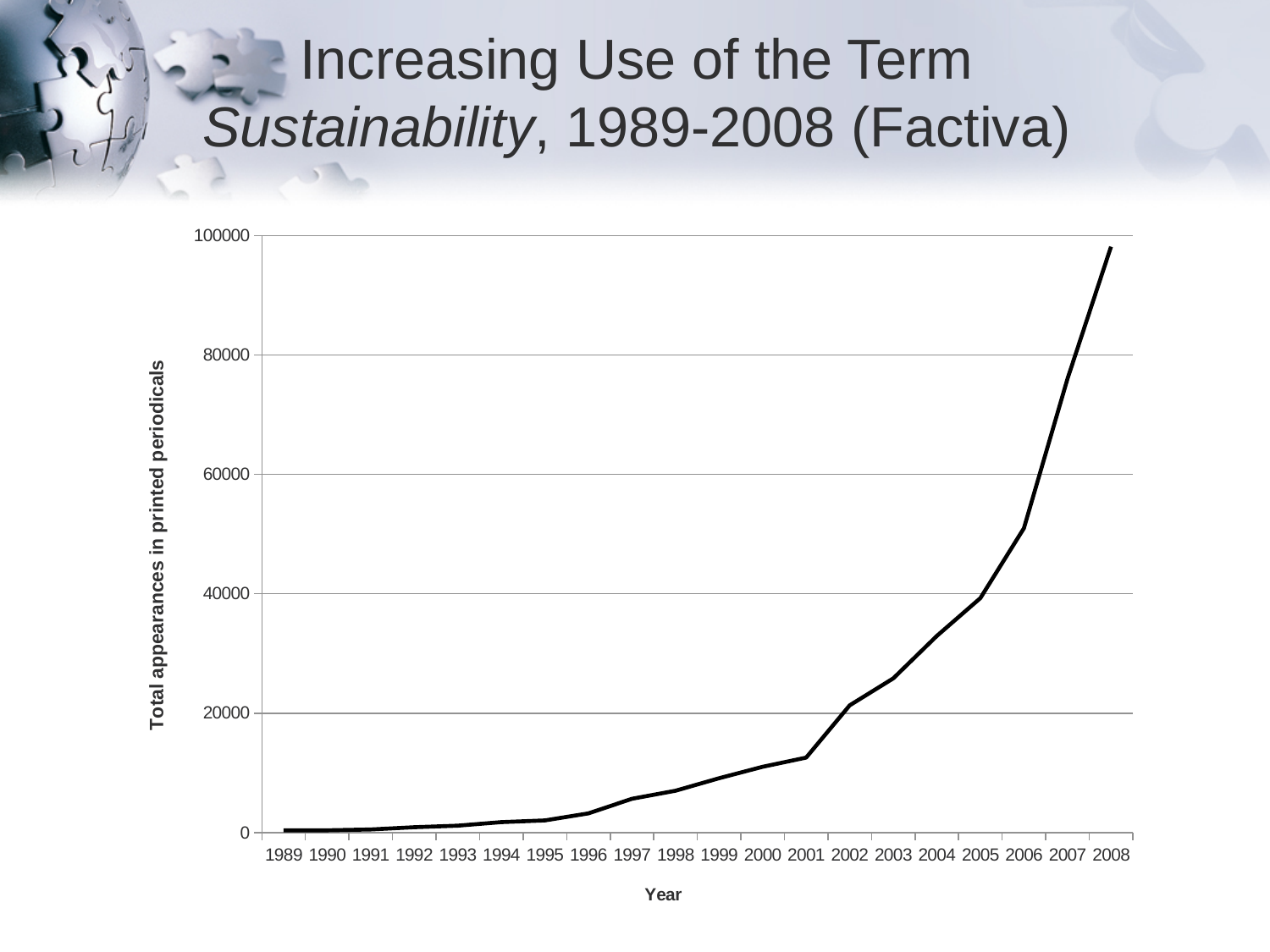
Is the value for 2008 greater or less than 80000? greater Which year has the larger value, 2001 or 2006? 2006 What is the title of the y axis? Total appearances in printed periodicals Is the value for 2001 greater or less than 20000? less How many years are plotted on the x axis? 20 Is the value for 2007 greater or less than 60000? greater What is the title of the x axis? Year Which year has the highest total appearances in printed periodicals? 2008 Do the values generally rise or fall from 1989 to 2008? rise What kind of chart is shown on the slide? line chart